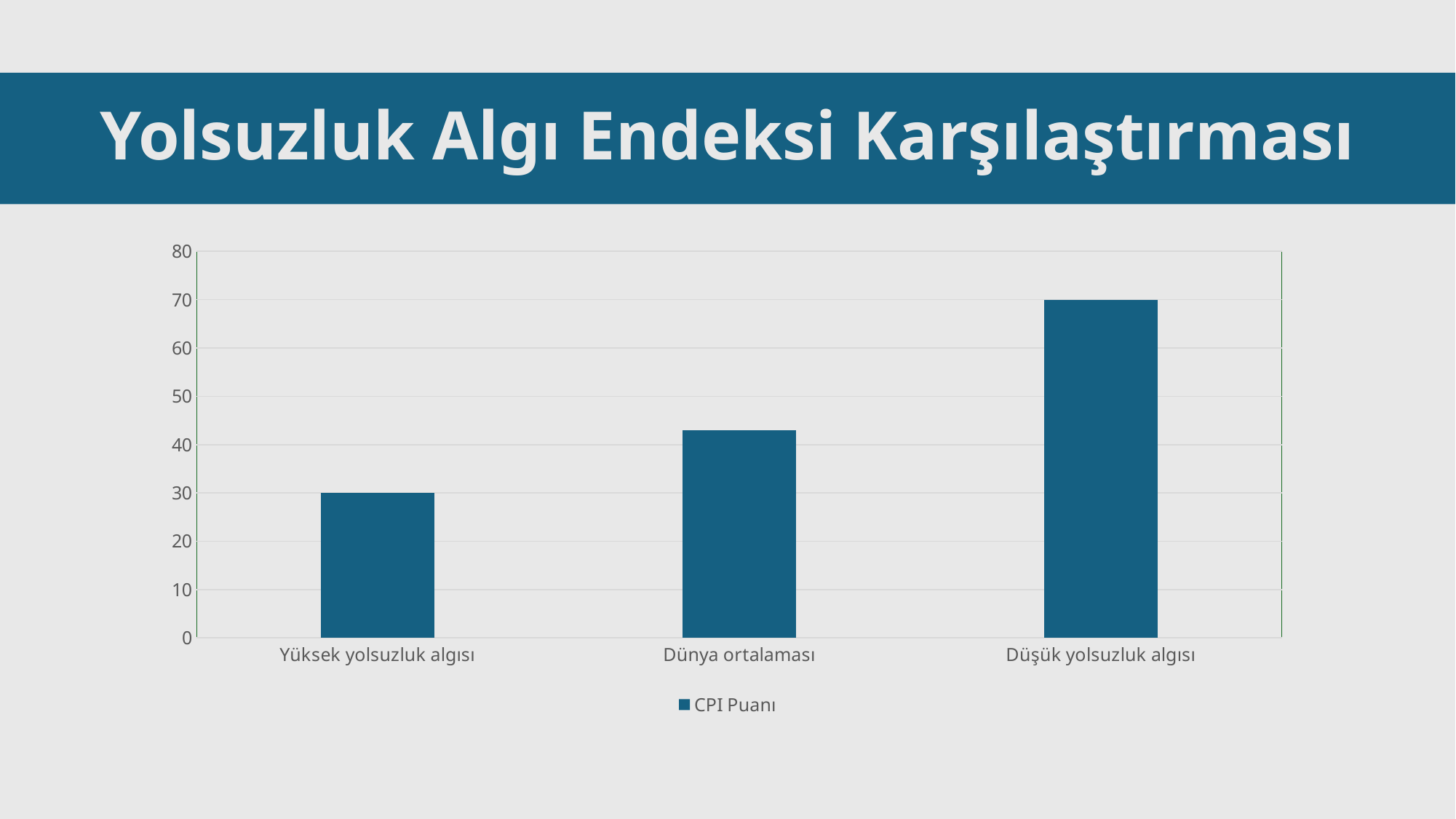
How many categories are shown on the x axis of the chart? 3 What is the CPI Puanı value for Yüksek yolsuzluk algısı? 30 Is the value for Dünya ortalaması greater or less than 40? greater What type of chart is shown on the slide? bar chart Which category has the lowest CPI Puanı value? Yüksek yolsuzluk algısı Do the values rise or fall from left to right along the x axis? rise How many series does the chart legend list? 1 What is the difference between the CPI Puanı values for Düşük yolsuzluk algısı and Yüksek yolsuzluk algısı? 40 Which category has the highest CPI Puanı value? Düşük yolsuzluk algısı What is the CPI Puanı value for Düşük yolsuzluk algısı? 70 What is the name of the series shown in the chart legend? CPI Puanı What is the title of the slide containing the chart? Yolsuzluk Algı Endeksi Karşılaştırması